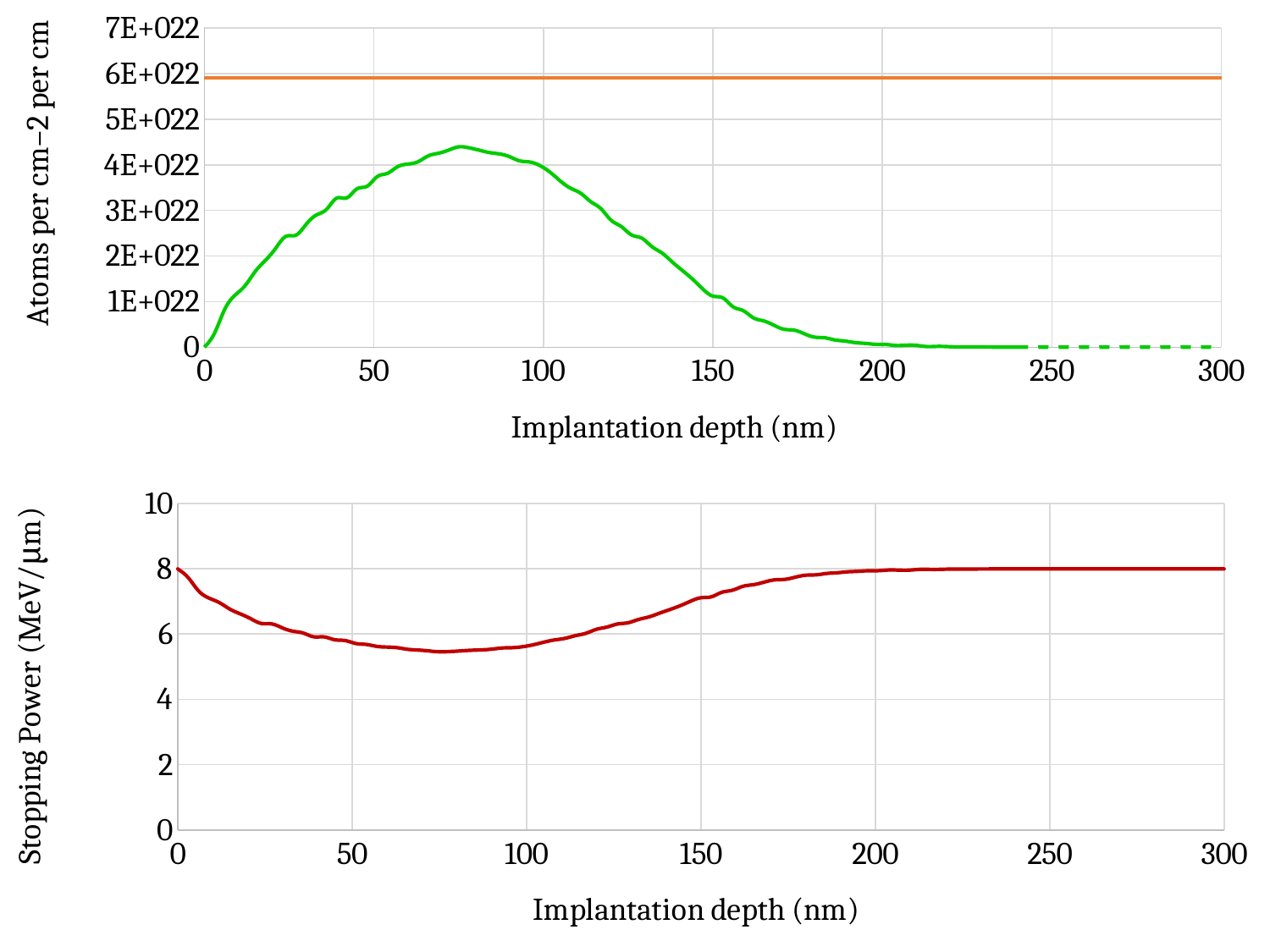
In the bottom chart, does the stopping power rise or fall as the implantation depth increases from 100 to 200 nm? rise In the bottom chart, is the stopping power at an implantation depth of 75 nm greater or less than 6? less What kind of chart is the bottom chart on the slide? line chart In the top chart, is the value of the green curve at an implantation depth of 75 nm greater or less than 4E+022? greater What kind of chart is the top chart on the slide? line chart In the bottom chart, what is the label of the y axis? Stopping Power (MeV/μm) In the bottom chart, is the stopping power at an implantation depth of 250 nm greater or less than 6? greater In the bottom chart, does the stopping power rise or fall as the implantation depth increases from 0 to 50 nm? fall In the top chart, what is the label of the y axis? Atoms per cm-2 per cm In the top chart, does the green curve rise or fall as the implantation depth increases from 100 to 200 nm? fall